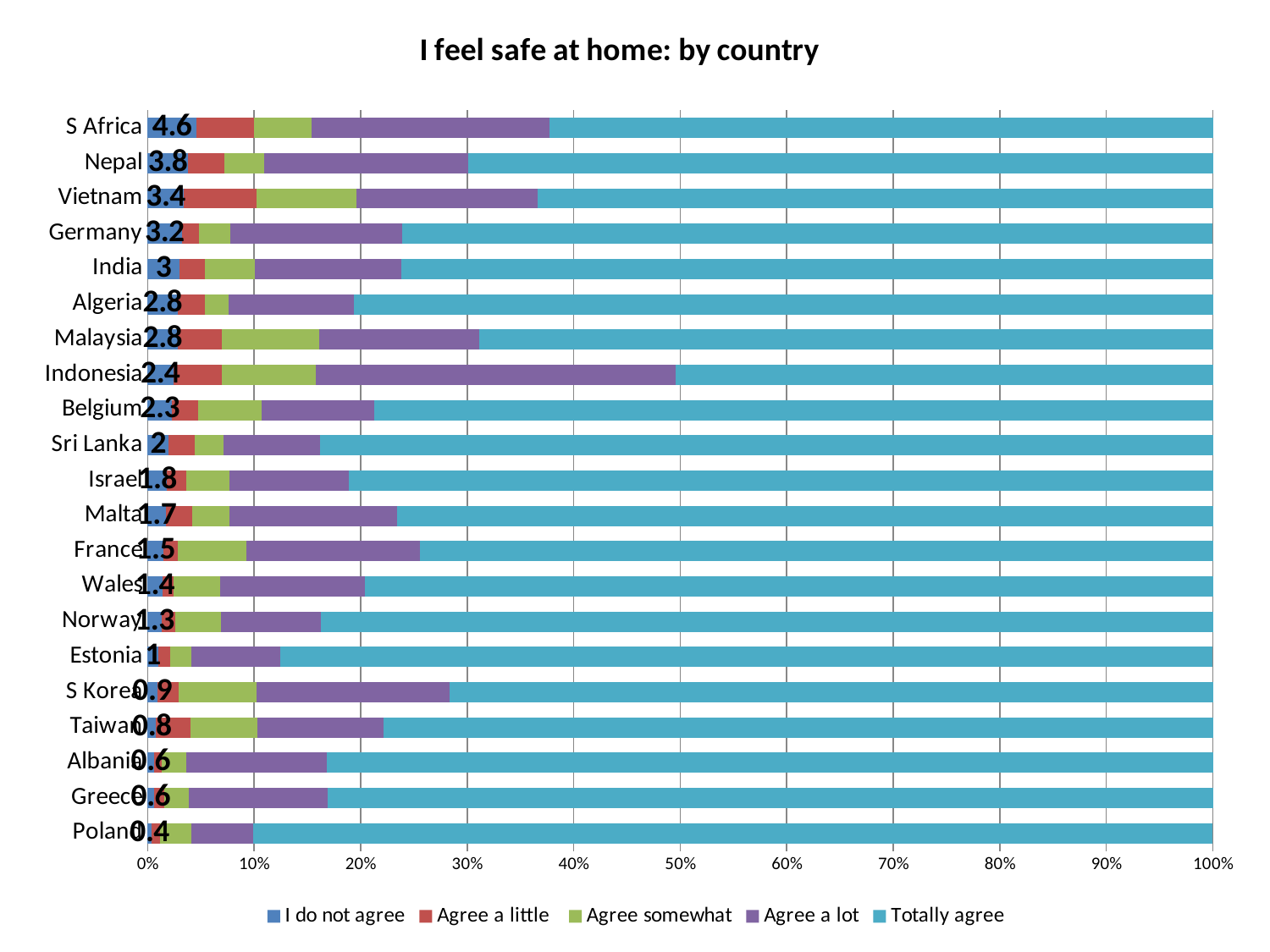
How many series does the legend list? 5 Is the 'Totally agree' share for Poland greater or less than 80%? greater Which country has the lowest 'I do not agree' value? Poland What is the 'I do not agree' value for S Africa? 4.6 Is the 'Totally agree' share for Indonesia greater or less than 60%? less Which country has the highest 'I do not agree' value? S Africa What kind of chart is shown on the slide? Stacked bar chart How many countries are shown in the chart? 21 What is the 'I do not agree' value for Indonesia? 2.4 What is the difference between the 'I do not agree' values for S Africa and Poland? 4.2 Which has a larger 'I do not agree' value, Germany or India? Germany What is the 'I do not agree' value for Estonia? 1